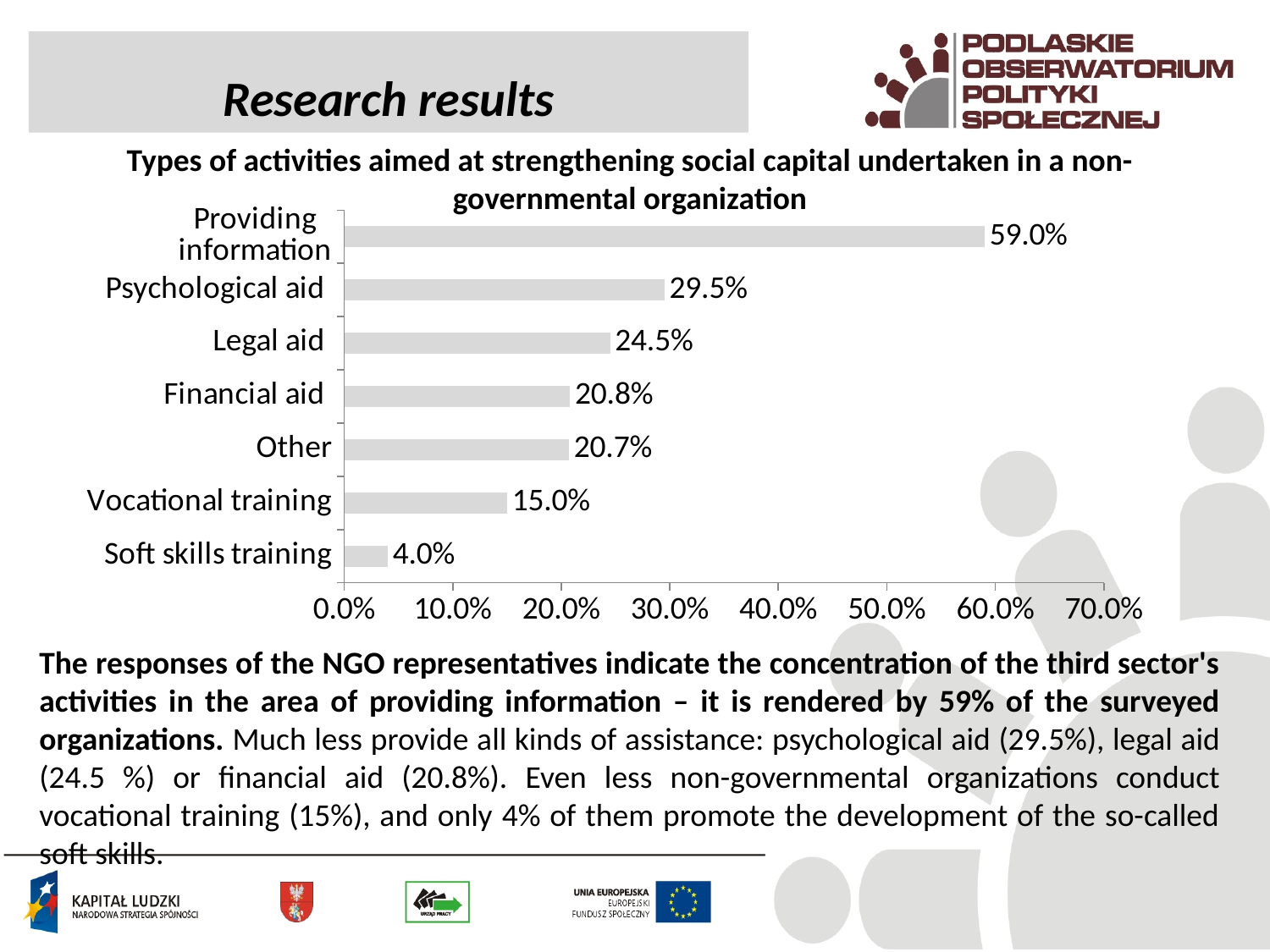
Which category has the highest value? Providing information Which category has the lowest value? Soft skills training What is the value for Providing information? 59.0% How many categories are shown in the chart? 7 What kind of chart is shown on the slide? bar chart What is the difference between the values for Providing information and Psychological aid? 29.5% What is the value for Legal aid? 24.5% Is the value for Vocational training greater or less than 20.0%? less What is the value for Vocational training? 15.0% What is the title of the chart? Types of activities aimed at strengthening social capital undertaken in a non-governmental organization What is the difference between the values for Legal aid and Financial aid? 3.7% Which is larger, the value for Psychological aid or the value for Legal aid? Psychological aid